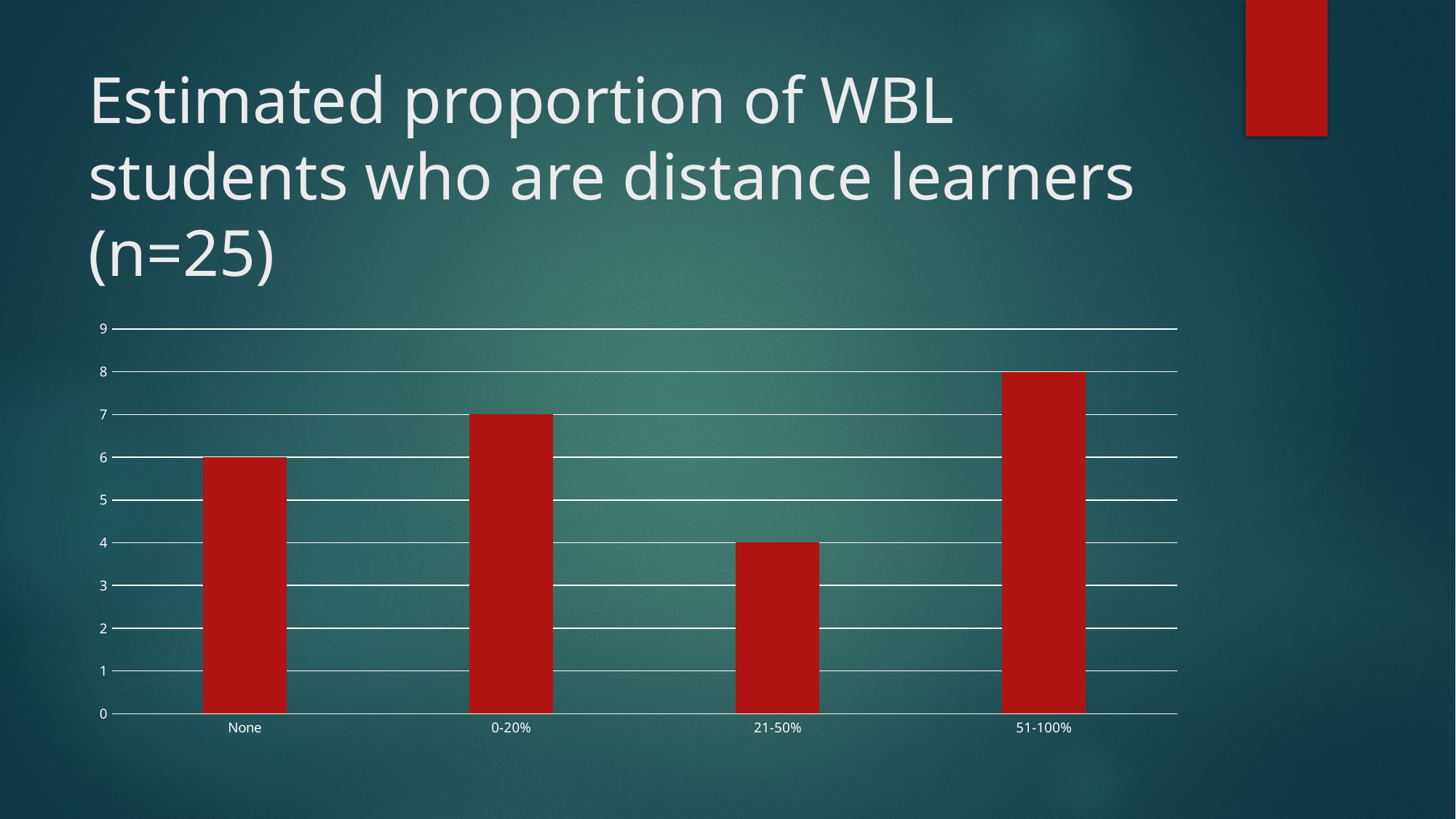
What is the difference between the values for 51-100% and 21-50%? 4 What is the value for the 51-100% category? 8 What is the title of the slide containing the chart? Estimated proportion of WBL students who are distance learners (n=25) What is the value for the 0-20% category? 7 Is the value for 21-50% greater or less than 5? less What is the value for the None category? 6 Which category has the highest value? 51-100% What is the value for the 21-50% category? 4 What kind of chart is shown on the slide? bar chart How many categories are shown on the x axis? 4 Which category has the lowest value? 21-50% Which is larger, the value for None or the value for 0-20%? 0-20%